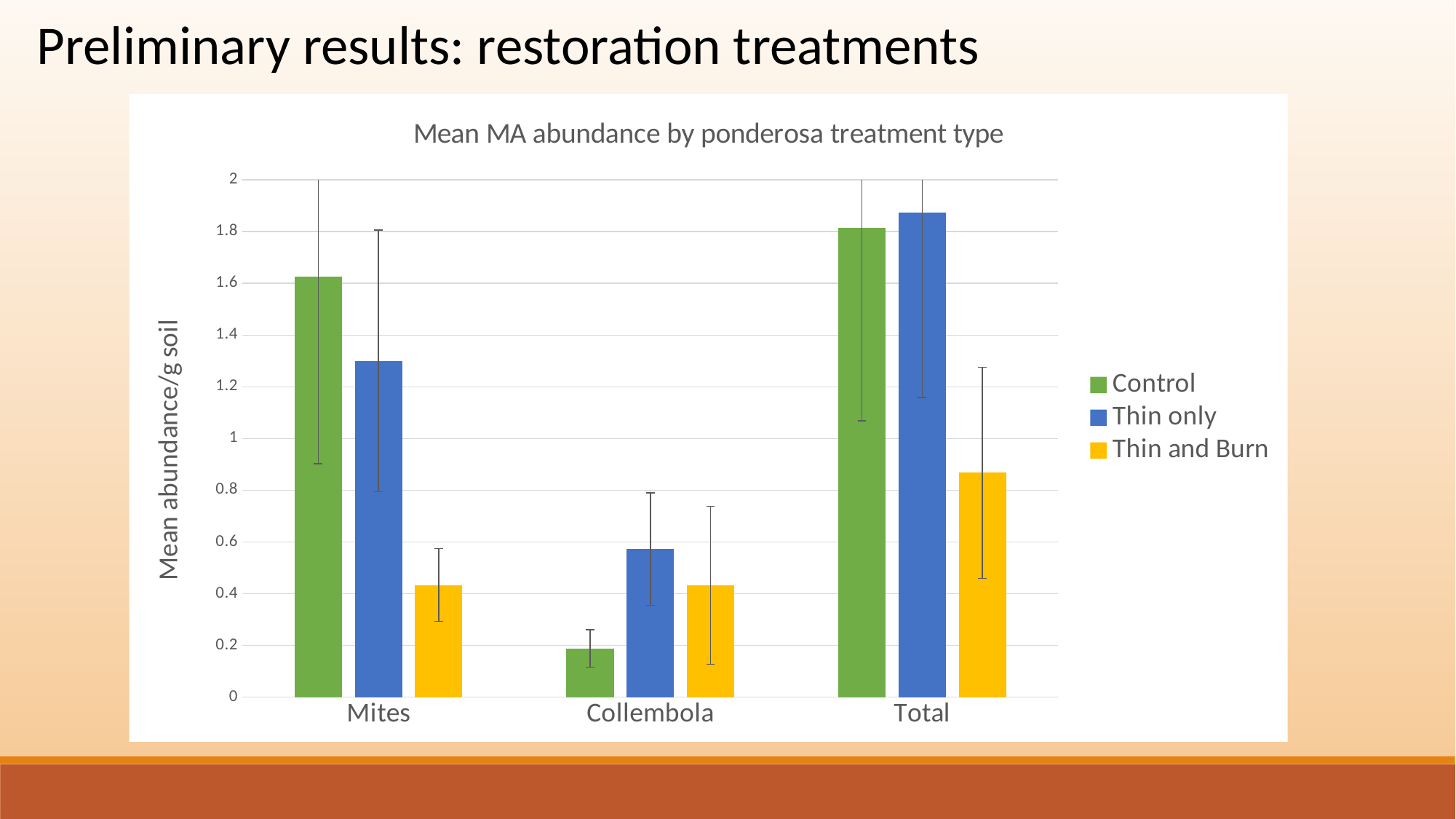
Is the Control value for Collembola greater or less than 0.4? less How many series does the legend list? 3 Which treatment has the lowest value for Collembola? Control For Mites, which is larger: the Control value or the Thin only value? Control Is the Control value for Mites greater or less than 1.4? greater What is the label on the y axis? Mean abundance/g soil What is the title of the chart? Mean MA abundance by ponderosa treatment type How many categories are shown on the x axis? 3 What kind of chart is shown on the slide? bar chart For Collembola, which is larger: the Control value or the Thin only value? Thin only Is the Thin only value for Collembola greater or less than 0.4? greater